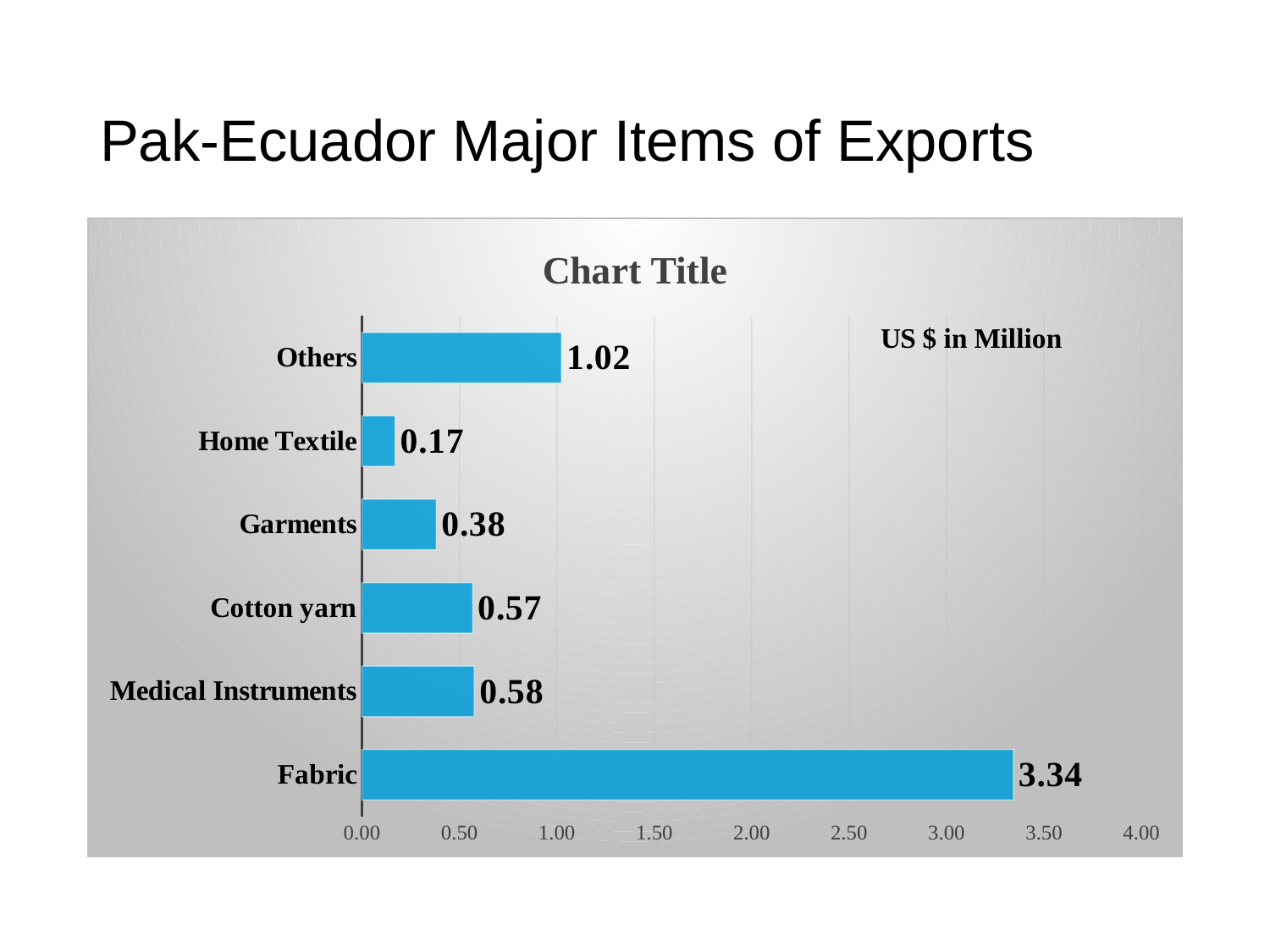
Which category has the lowest value? Home Textile Which is larger, the value for Garments or the value for Cotton yarn? Cotton yarn What is the difference between the values for Cotton yarn and Garments? 0.19 What is the value for Others? 1.02 Which category has the highest value? Fabric What kind of chart is shown on the slide? bar chart What is the value for Home Textile? 0.17 Is the value for Fabric greater or less than 3.00? greater What is the value for Fabric? 3.34 What unit is stated in the text label inside the chart area? US $ in Million What is the difference between the values for Fabric and Others? 2.32 How many categories are shown in the chart? 6